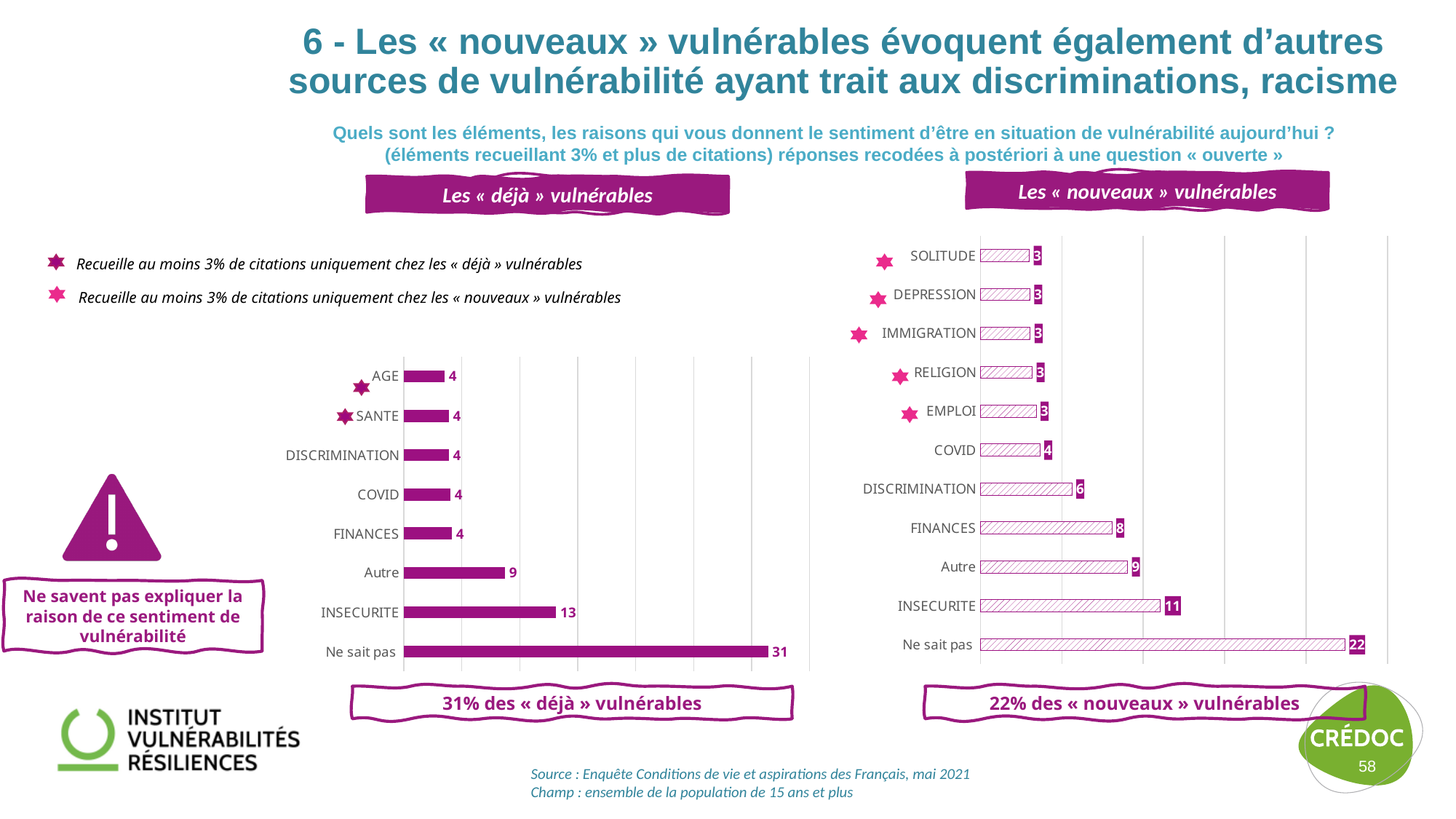
In the chart 'Les « nouveaux » vulnérables', what is the value for FINANCES? 8 What kind of chart is 'Les « déjà » vulnérables'? Bar chart In the chart 'Les « nouveaux » vulnérables', what is the value for COVID? 4 In the chart 'Les « déjà » vulnérables', what is the difference between the values for Ne sait pas and INSECURITE? 18 Which is larger: the value for DISCRIMINATION in the chart 'Les « déjà » vulnérables' or the value for DISCRIMINATION in the chart 'Les « nouveaux » vulnérables'? Les « nouveaux » vulnérables In the chart 'Les « nouveaux » vulnérables', which category has the highest value? Ne sait pas In the chart 'Les « nouveaux » vulnérables', what is the difference between the values for INSECURITE and DISCRIMINATION? 5 In the chart 'Les « nouveaux » vulnérables', what is the value for Autre? 9 How many categories are shown in the chart 'Les « déjà » vulnérables'? 8 In the chart 'Les « déjà » vulnérables', which category has the highest value? Ne sait pas How many categories are shown in the chart 'Les « nouveaux » vulnérables'? 11 In the chart 'Les « déjà » vulnérables', what is the value for INSECURITE? 13